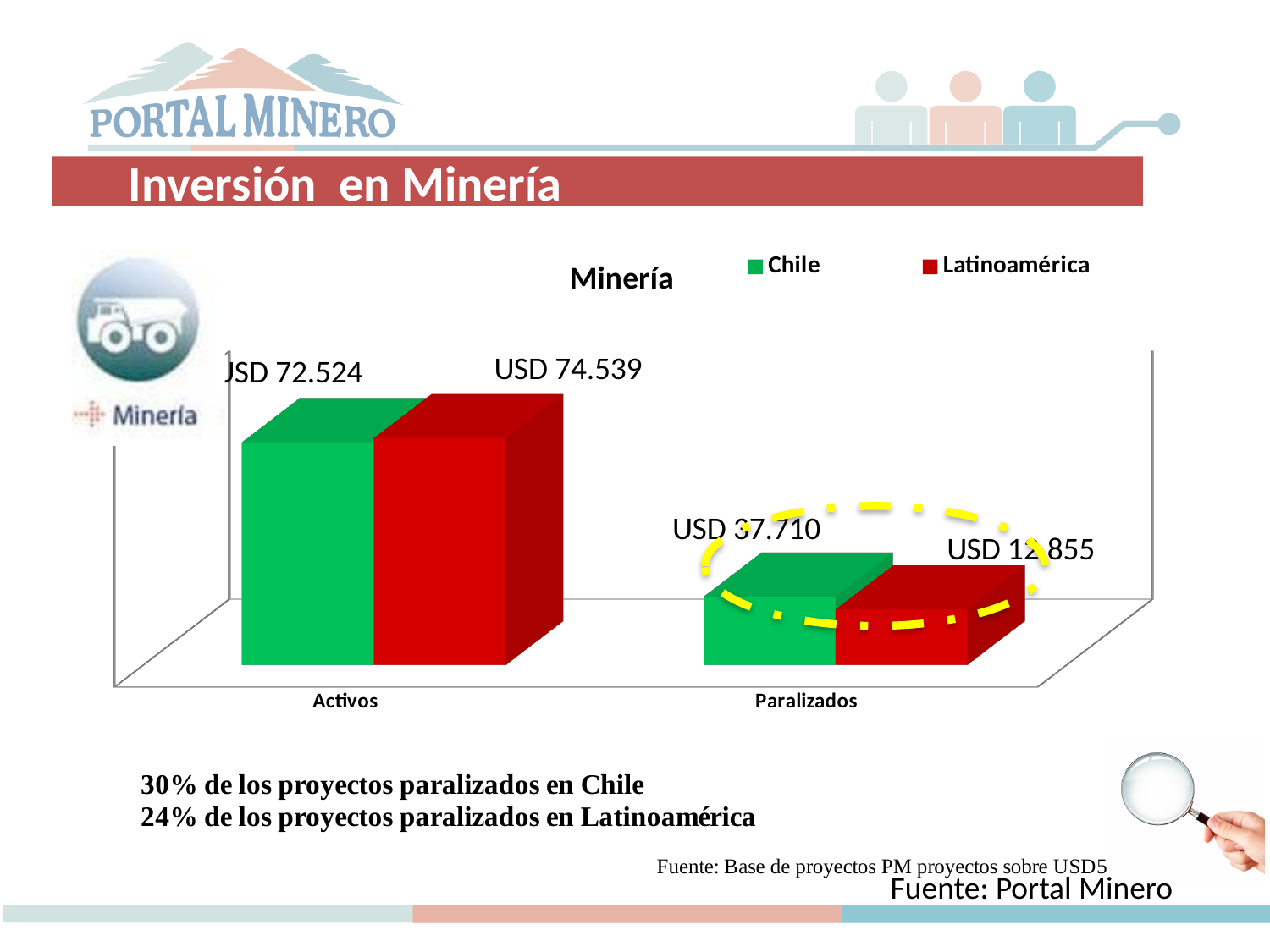
How many series does the legend list? 2 How many categories are shown on the x axis of the chart? 2 What is the value for Chile in the Activos category? USD 72.524 What is the value for Latinoamérica in the Activos category? USD 74.539 In the Activos category, which series has the larger value, Chile or Latinoamérica? Latinoamérica What kind of chart is shown on the slide? Bar chart What is the difference between the Chile values for Activos and Paralizados? USD 34.814 In the Paralizados category, which series has the larger value, Chile or Latinoamérica? Chile What is the value for Chile in the Paralizados category? USD 37.710 What is the difference between the Latinoamérica and Chile values in the Activos category? USD 2.015 What is the title of the chart? Minería In which category does Chile have its highest value? Activos